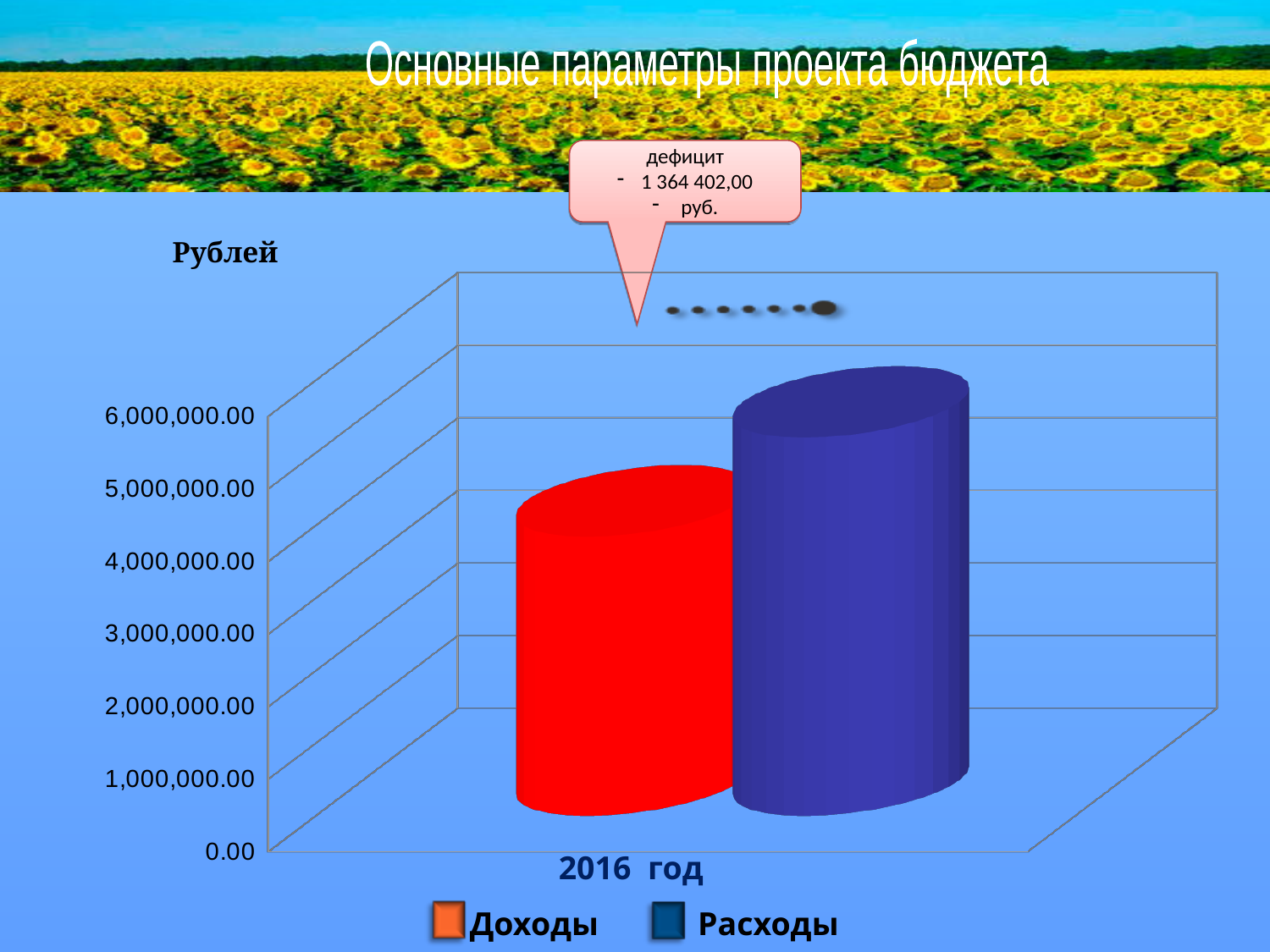
Which series has the higher value for 2016 год, Доходы or Расходы? Расходы Is the value for Расходы greater or less than 4,000,000.00? greater Which series has the shortest bar? Доходы How many categories are shown on the x axis? 1 Is the value for Доходы greater or less than 3,000,000.00? greater Which series has the tallest bar? Расходы How many series does the legend list? 2 What deficit value is shown in the callout above the chart? 1 364 402,00 руб. What label is shown above the vertical axis? Рублей What type of chart is shown on the slide? bar chart Is the value for Доходы greater or less than 5,000,000.00? less